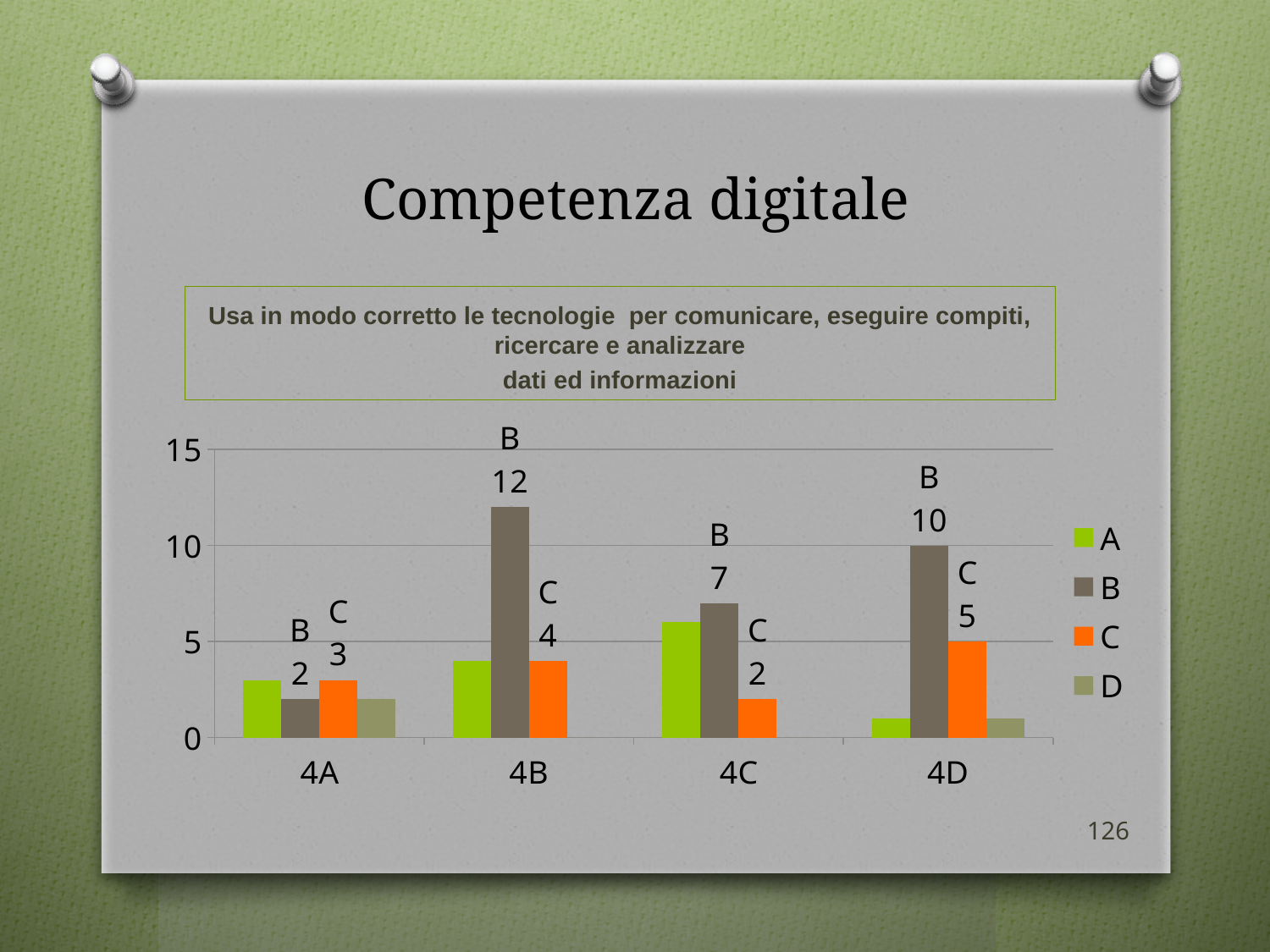
How many classes are shown on the x axis? 4 What is the difference between the series B values for 4B and 4D? 2 What is the title of the slide containing the chart? Competenza digitale What is the value of series B for class 4C? 7 Is the value of series A for class 4C greater or less than 5? greater What kind of chart is shown on the slide? bar chart What is the value of series C for class 4D? 5 Which class has the larger value for series C, 4B or 4D? 4D Which class has the highest value for series B? 4B What is the value of series B for class 4B? 12 Which class has the lowest value for series B? 4A How many series does the legend list? 4